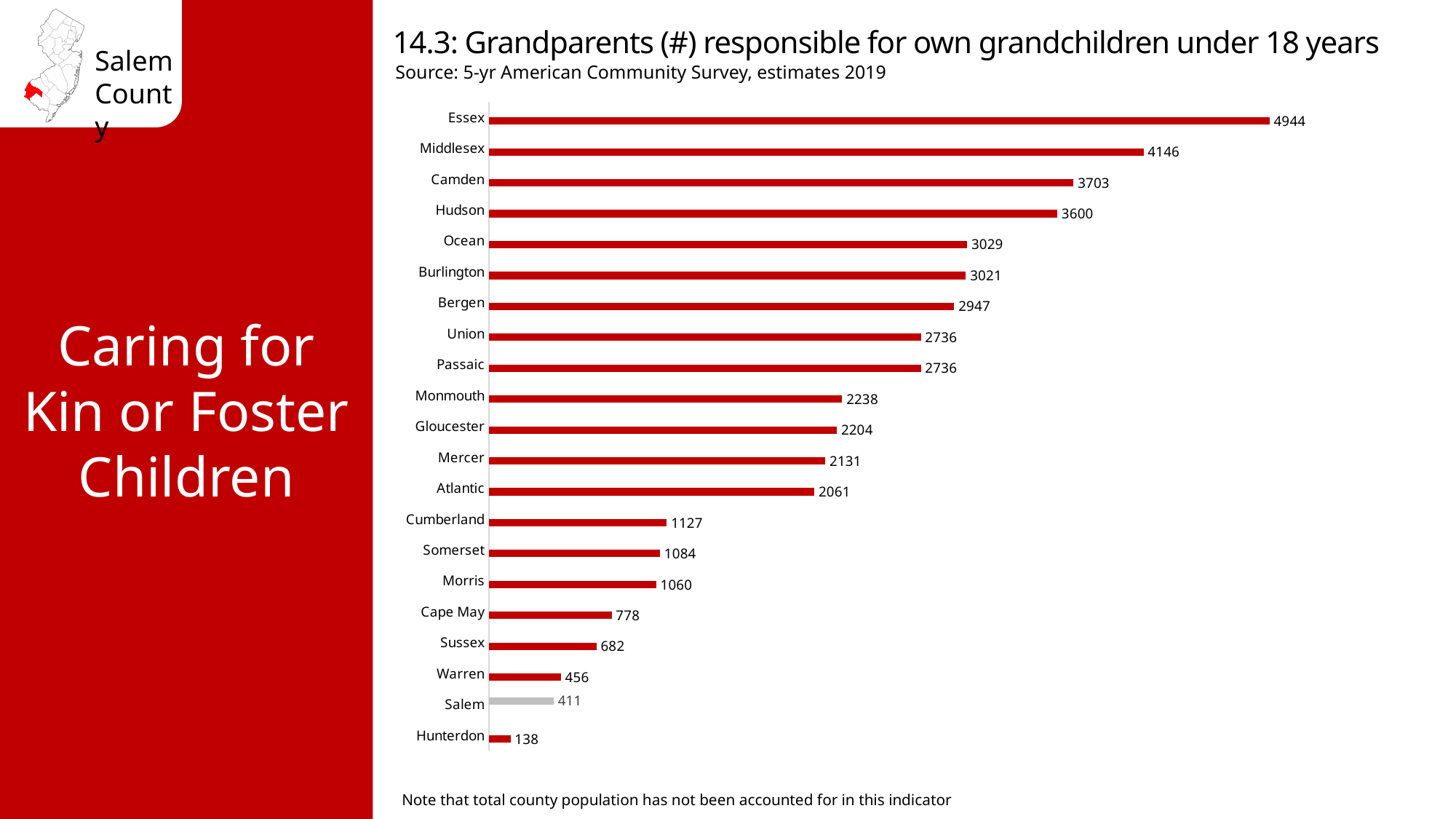
What is the difference between the values for Essex and Middlesex? 798 What is the difference between the values for Salem and Hunterdon? 273 What is the value shown for Essex? 4944 What is the value shown for Cumberland? 1127 Which county has the highest number of grandparents responsible for own grandchildren? Essex Which has a larger value, Warren or Salem? Warren How many counties are shown in the chart? 21 Which county has the lowest number of grandparents responsible for own grandchildren? Hunterdon Which has a larger value, Camden or Hudson? Camden What type of chart is shown on the slide? Bar chart Which county's bar is shown in grey rather than red? Salem What is the number of grandparents responsible for own grandchildren under 18 years in Salem County? 411